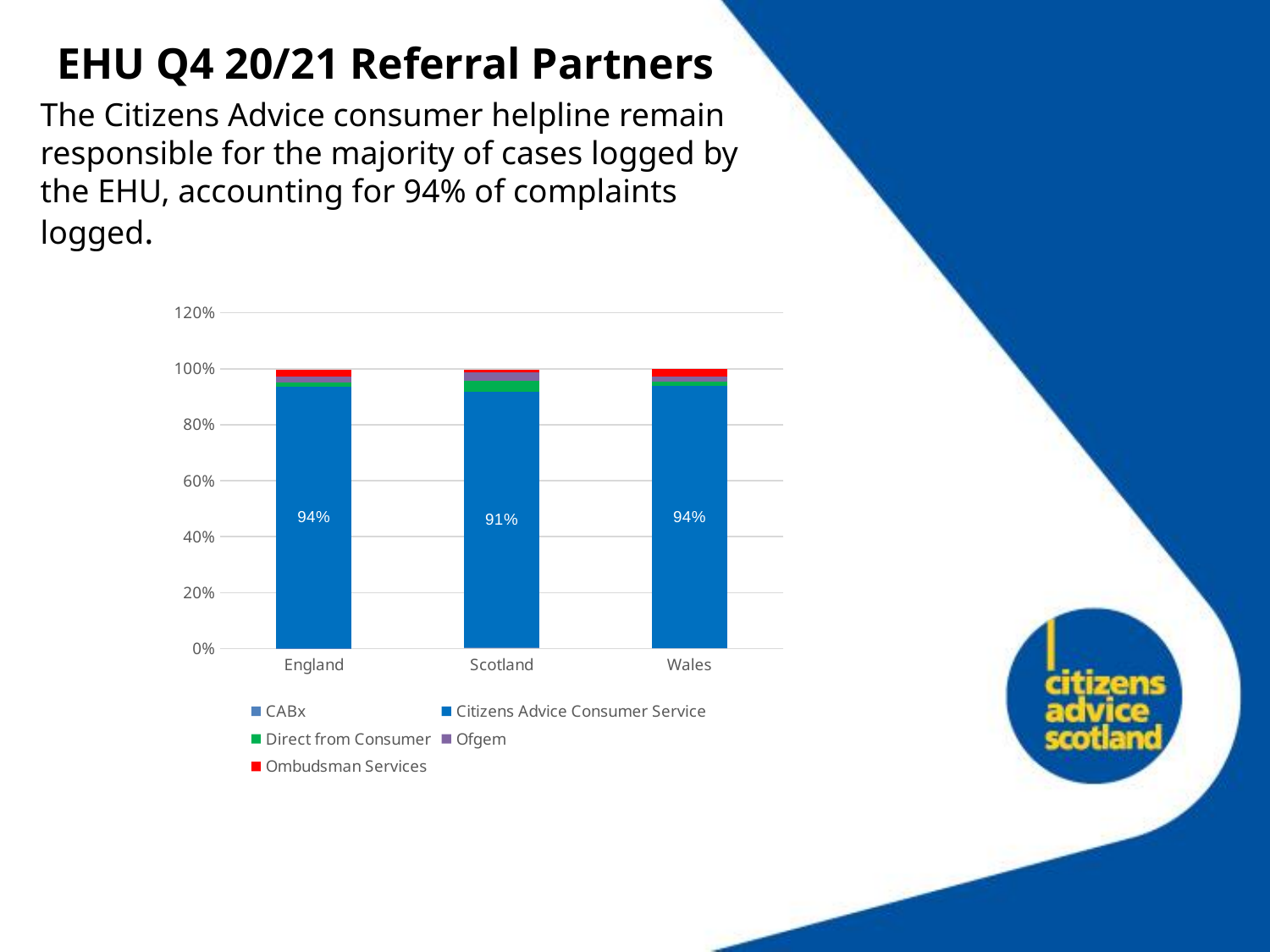
Which country has the lowest share of cases from the Citizens Advice Consumer Service? Scotland What percentage of cases in Wales came from the Citizens Advice Consumer Service? 94% Is the Citizens Advice Consumer Service share larger for England or for Scotland? England Is the Citizens Advice Consumer Service share for Scotland greater or less than 80%? greater What percentage of cases in England came from the Citizens Advice Consumer Service? 94% How many series does the chart legend list? 5 What is the total height of the stacked bar for Wales? 100% Which colour represents Ombudsman Services in the chart legend? Red What is the difference between the Citizens Advice Consumer Service share for England and for Scotland? 3% What kind of chart is shown on the slide? Stacked bar chart What percentage of cases in Scotland came from the Citizens Advice Consumer Service? 91% How many countries are shown on the x axis of the chart? 3